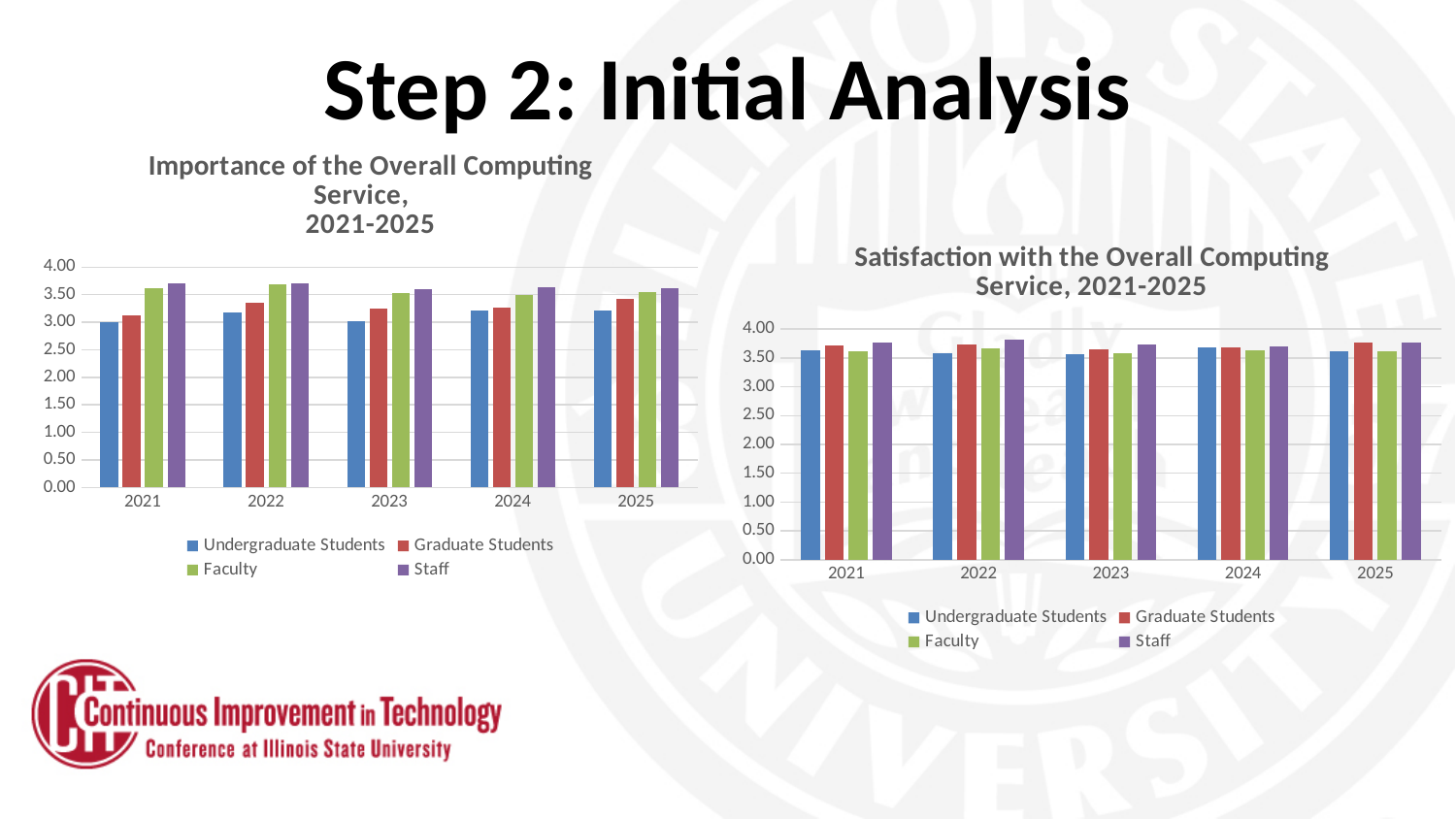
In the 'Satisfaction with the Overall Computing Service, 2021-2025' chart, is the value for Faculty in 2024 greater or less than 3.00? greater In the 'Satisfaction with the Overall Computing Service, 2021-2025' chart, is the value for Staff in 2022 greater or less than 3.50? greater In the 'Satisfaction with the Overall Computing Service, 2021-2025' chart, is the value for Undergraduate Students in 2021 greater or less than 3.00? greater What kind of chart is the 'Importance of the Overall Computing Service, 2021-2025' chart? bar chart How many series does the legend of the 'Satisfaction with the Overall Computing Service, 2021-2025' chart list? 4 In the 'Importance of the Overall Computing Service, 2021-2025' chart, which is larger in 2023: Undergraduate Students or Faculty? Faculty How many years are shown on the x axis of the 'Importance of the Overall Computing Service, 2021-2025' chart? 5 In the 'Importance of the Overall Computing Service, 2021-2025' chart, which is larger in 2021: Undergraduate Students or Staff? Staff What is the title of the chart on the right side of the slide? Satisfaction with the Overall Computing Service, 2021-2025 Which series is shown in green in the 'Importance of the Overall Computing Service, 2021-2025' chart? Faculty